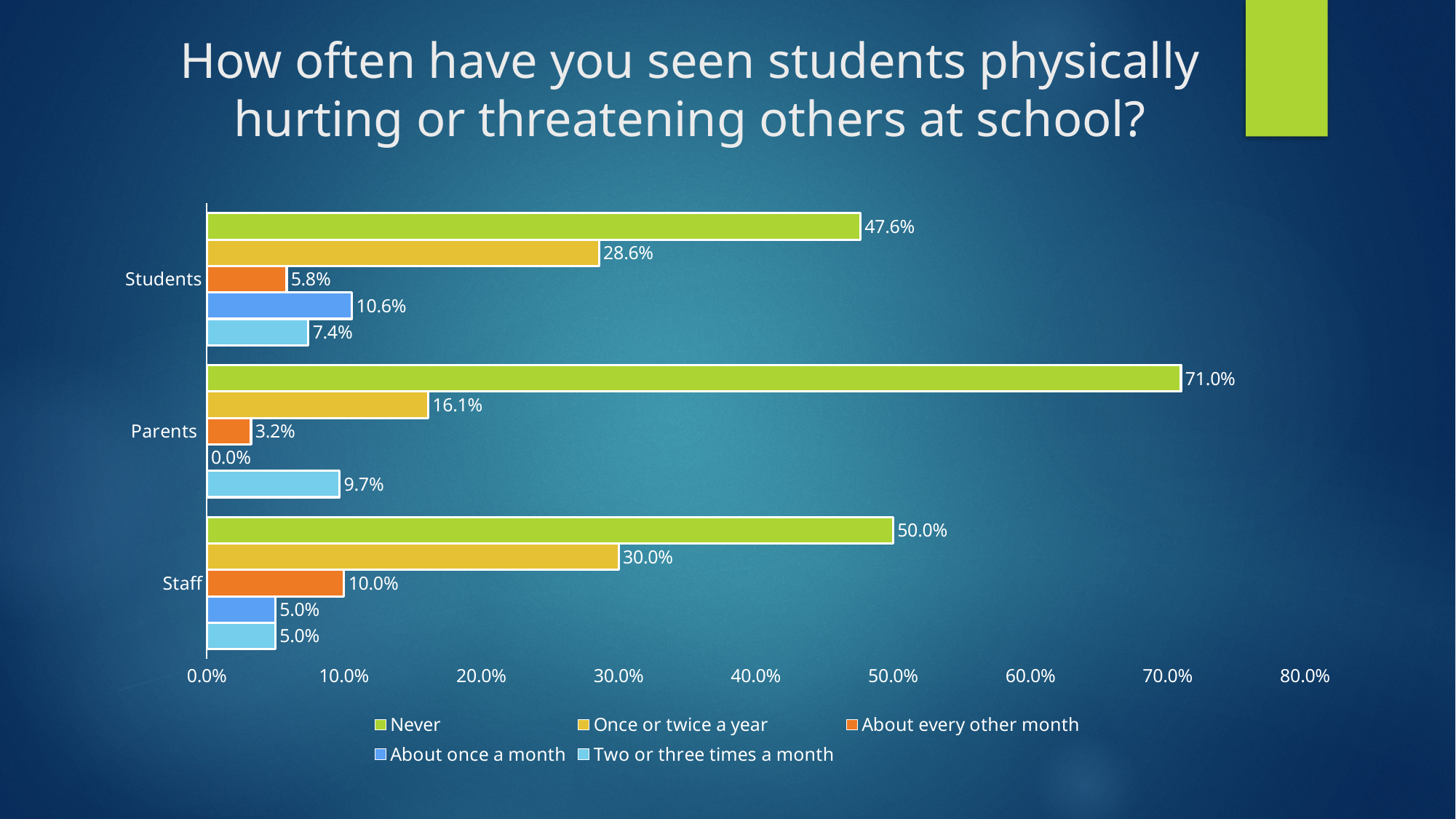
Is the "Once or twice a year" value for Staff greater or less than 20.0%? greater What percentage of Students answered "Never"? 47.6% How many groups are shown on the vertical axis? 3 What is the difference between the "Never" values for Parents and Students? 23.4% What percentage of Parents answered "About once a month"? 0.0% Which is larger: the "Two or three times a month" value for Parents or for Students? Parents Which group has the lowest value for "About every other month"? Parents What percentage of Staff answered "About every other month"? 10.0% What kind of chart is shown on the slide? Bar chart Which group has the highest value for "Never"? Parents What percentage of Parents answered "Once or twice a year"? 16.1% How many series does the legend list? 5